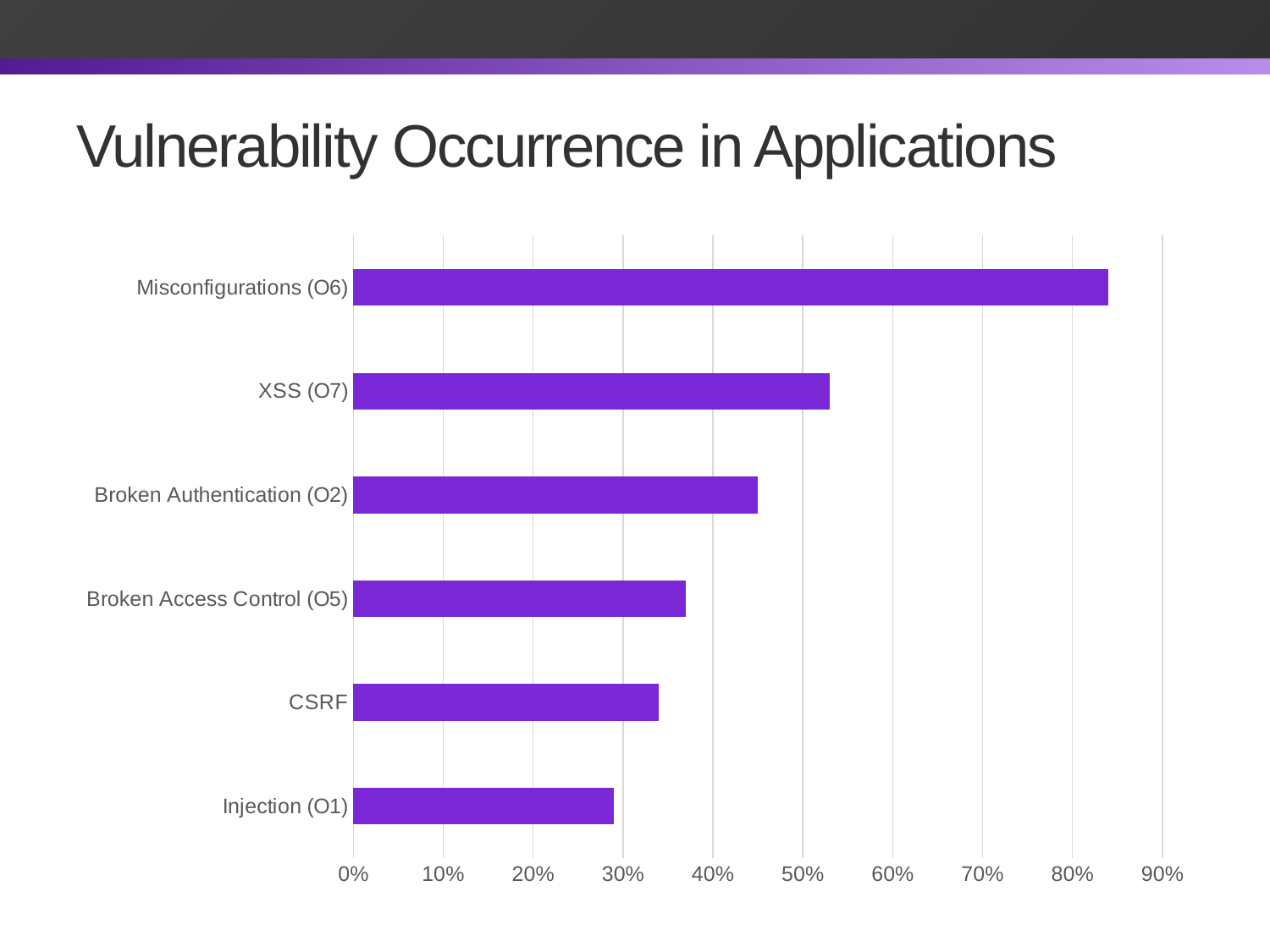
Which vulnerability category has the lowest occurrence? Injection (O1) Which vulnerability category has the highest occurrence? Misconfigurations (O6) What kind of chart is shown on the slide? Bar chart Is the value for CSRF greater or less than 30%? greater What is the title of the chart? Vulnerability Occurrence in Applications How many vulnerability categories are plotted in the chart? 6 Is the value for Misconfigurations (O6) greater or less than 80%? greater Is the value for Broken Authentication (O2) greater or less than 50%? less Which has a higher occurrence, Injection (O1) or Broken Access Control (O5)? Broken Access Control (O5) Which has a higher occurrence, XSS (O7) or Broken Authentication (O2)? XSS (O7)